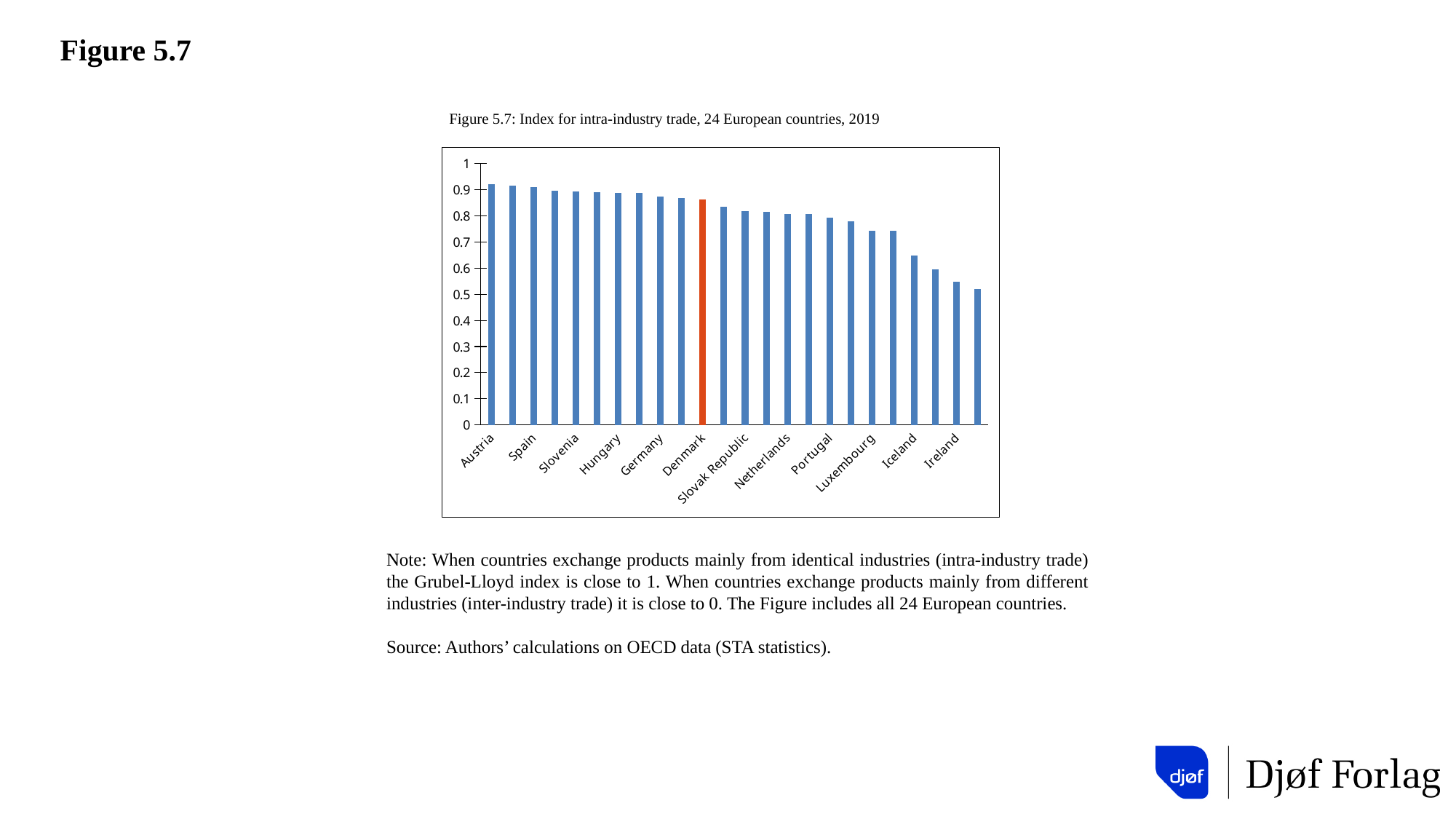
Is the value for Ireland greater or less than 0.6? less Is the value for Iceland greater or less than 0.7? less Is the value for Austria greater or less than 0.9? greater Which has the larger value, Denmark or Iceland? Denmark Which country's bar is highlighted in a different colour (red) from the others? Denmark How many countries (bars) are plotted in the chart? 24 Do the values rise or fall moving from left to right along the x axis? Fall What kind of chart is shown on the slide? Bar chart Which country has the highest index for intra-industry trade? Austria